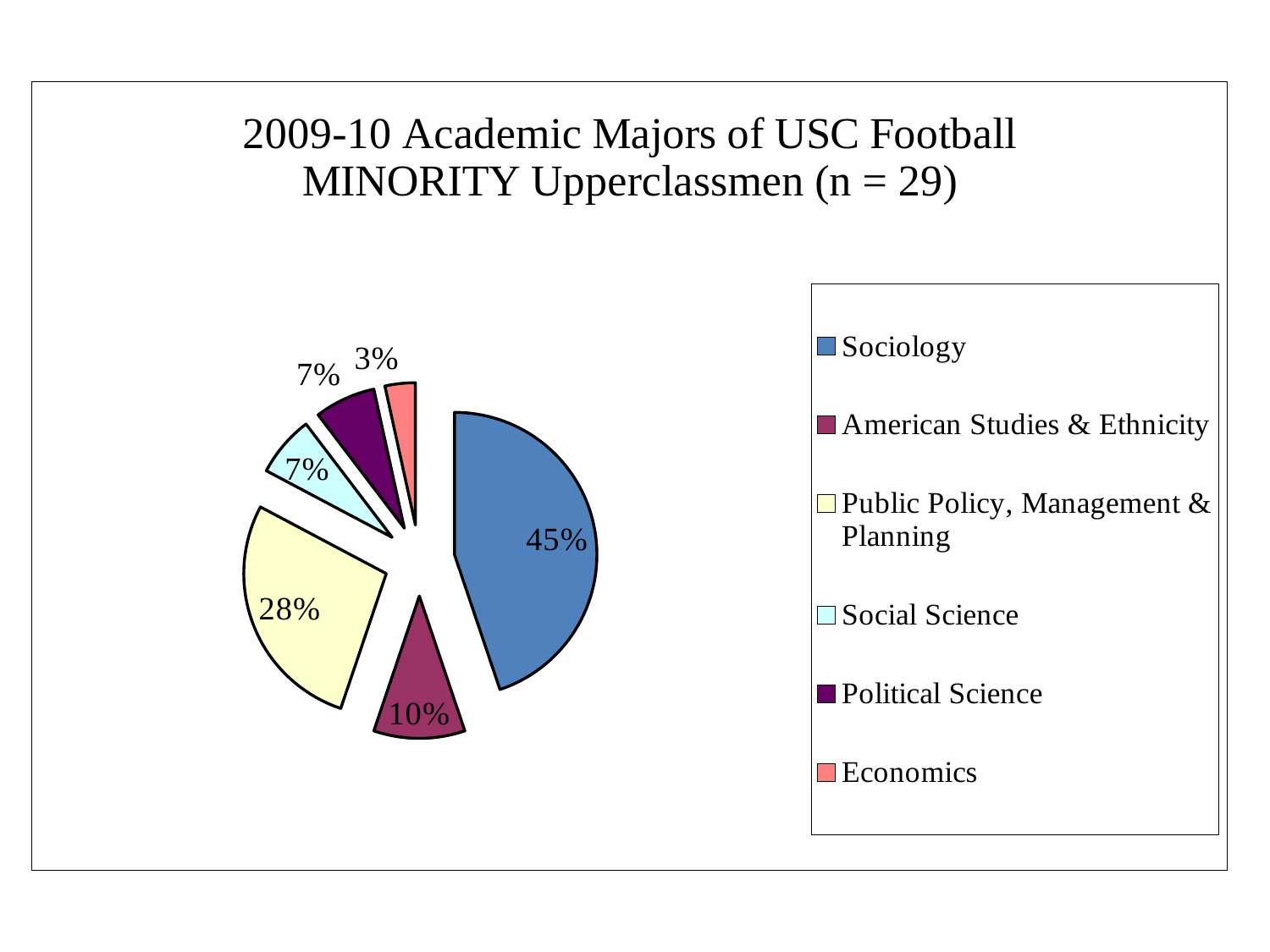
How many majors (slices) are shown in the pie chart? 6 Which major has the largest slice of the pie? Sociology What share of the pie does Public Policy, Management & Planning represent? 28% What is the title of the chart? 2009-10 Academic Majors of USC Football MINORITY Upperclassmen (n = 29) What share of the pie does Social Science represent? 7% What is the difference in percentage points between the Sociology slice and the Public Policy, Management & Planning slice? 17 Which slice is larger, American Studies & Ethnicity or Political Science? American Studies & Ethnicity What kind of chart is shown on the slide? pie chart What share of the pie does American Studies & Ethnicity represent? 10% Which major has the smallest slice of the pie? Economics